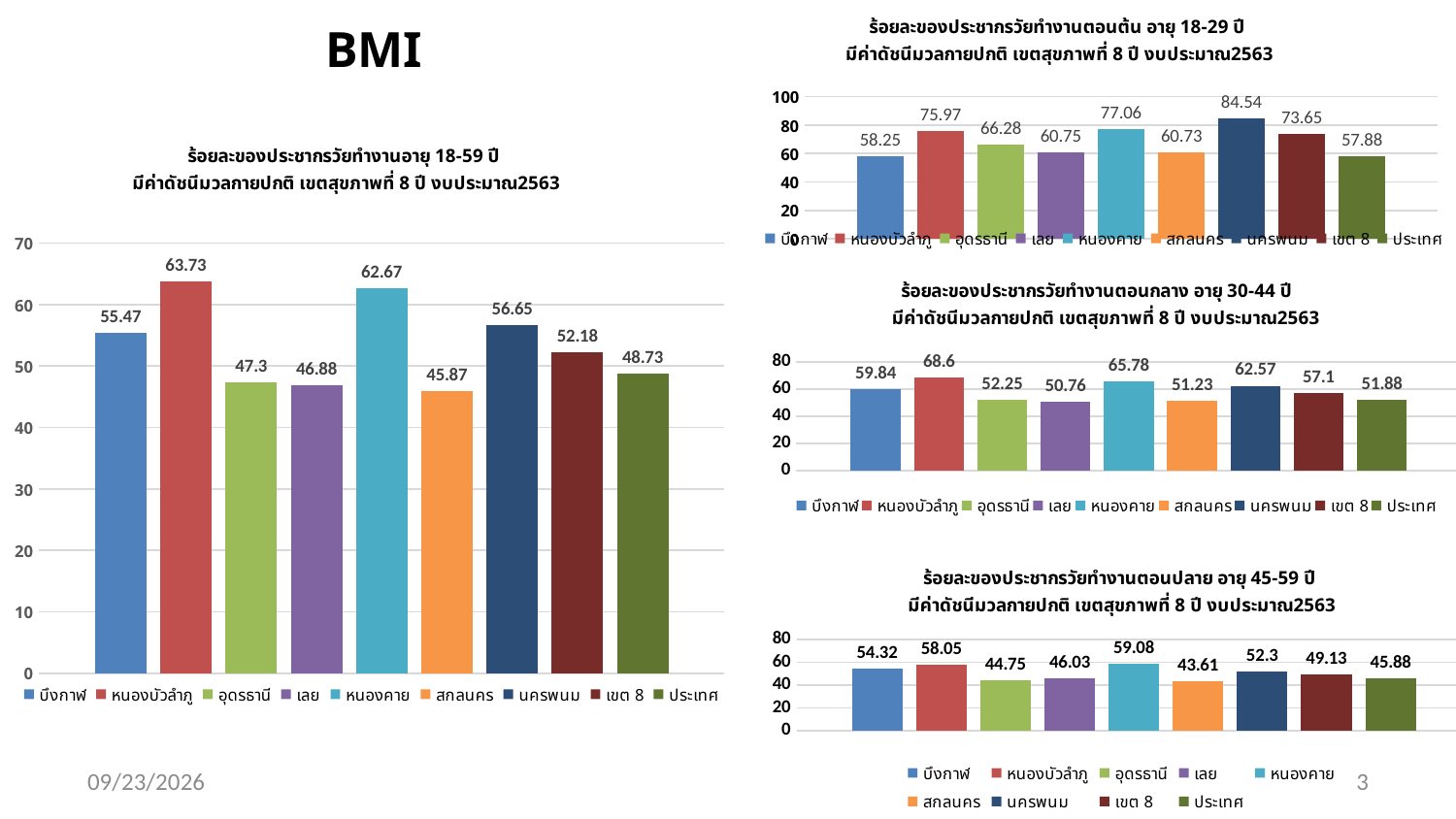
How many categories are shown in the large chart on the left (ages 18-59)? 9 In the top-right chart (ages 18-29), which is larger, the value for เขต 8 or the value for ประเทศ? เขต 8 In the large chart on the left (ages 18-59), what is the value for หนองบัวลำภู? 63.73 In the bottom-right chart (ages 45-59), what is the value for สกลนคร? 43.61 In the large chart on the left (ages 18-59), which category has the lowest value? สกลนคร In the middle-right chart (ages 30-44), which category has the highest value? หนองบัวลำภู In the middle-right chart (ages 30-44), what is the value for เลย? 50.76 In the top-right chart (ages 18-29), which category has the highest value? นครพนม In the large chart on the left (ages 18-59), what is the difference between หนองบัวลำภู and สกลนคร? 17.86 In the top-right chart (ages 18-29), what is the value for หนองคาย? 77.06 In the bottom-right chart (ages 45-59), what is the difference between หนองคาย and อุดรธานี? 14.33 What type of chart is the large chart on the left (ages 18-59)? bar chart